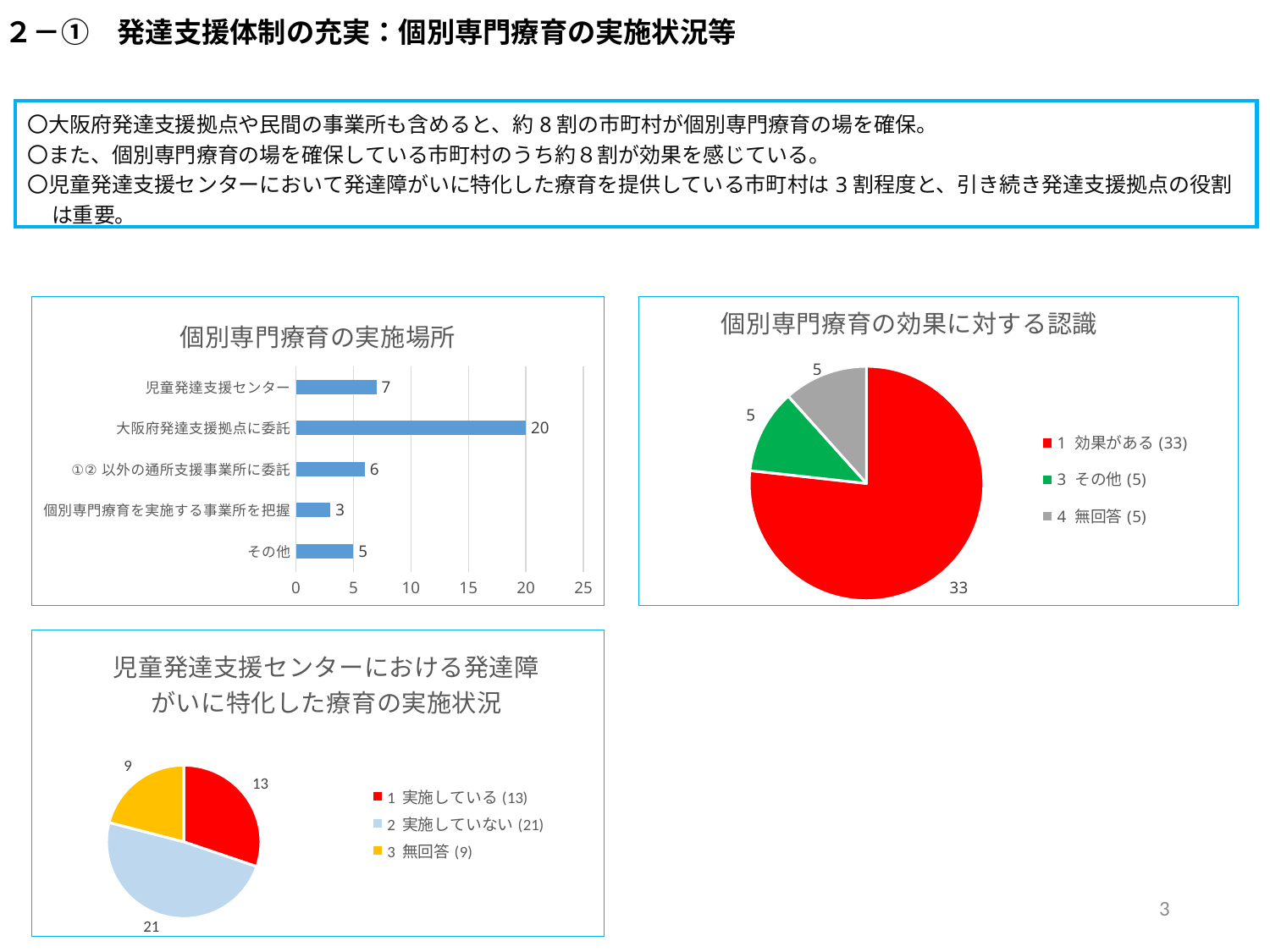
In the pie chart titled 児童発達支援センターにおける発達障がいに特化した療育の実施状況, what is the value for 実施していない? 21 In the pie chart titled 児童発達支援センターにおける発達障がいに特化した療育の実施状況, what colour is the 無回答 slice? Yellow In the pie chart titled 個別専門療育の効果に対する認識, what is the value for 効果がある? 33 In the pie chart titled 個別専門療育の効果に対する認識, how many entries does the legend list? 3 What kind of chart is the one titled 個別専門療育の実施場所? Bar chart In the chart titled 個別専門療育の実施場所, how many categories are shown? 5 In the chart titled 個別専門療育の実施場所, what is the value for 大阪府発達支援拠点に委託? 20 In the chart titled 個別専門療育の実施場所, which category has the lowest value? 個別専門療育を実施する事業所を把握 In the chart titled 個別専門療育の実施場所, which category has the highest value? 大阪府発達支援拠点に委託 In the chart titled 個別専門療育の実施場所, what is the difference between the values for 大阪府発達支援拠点に委託 and 児童発達支援センター? 13 In the pie chart titled 児童発達支援センターにおける発達障がいに特化した療育の実施状況, which is larger, 実施している or 無回答? 実施している In the chart titled 個別専門療育の実施場所, what is the value for 児童発達支援センター? 7